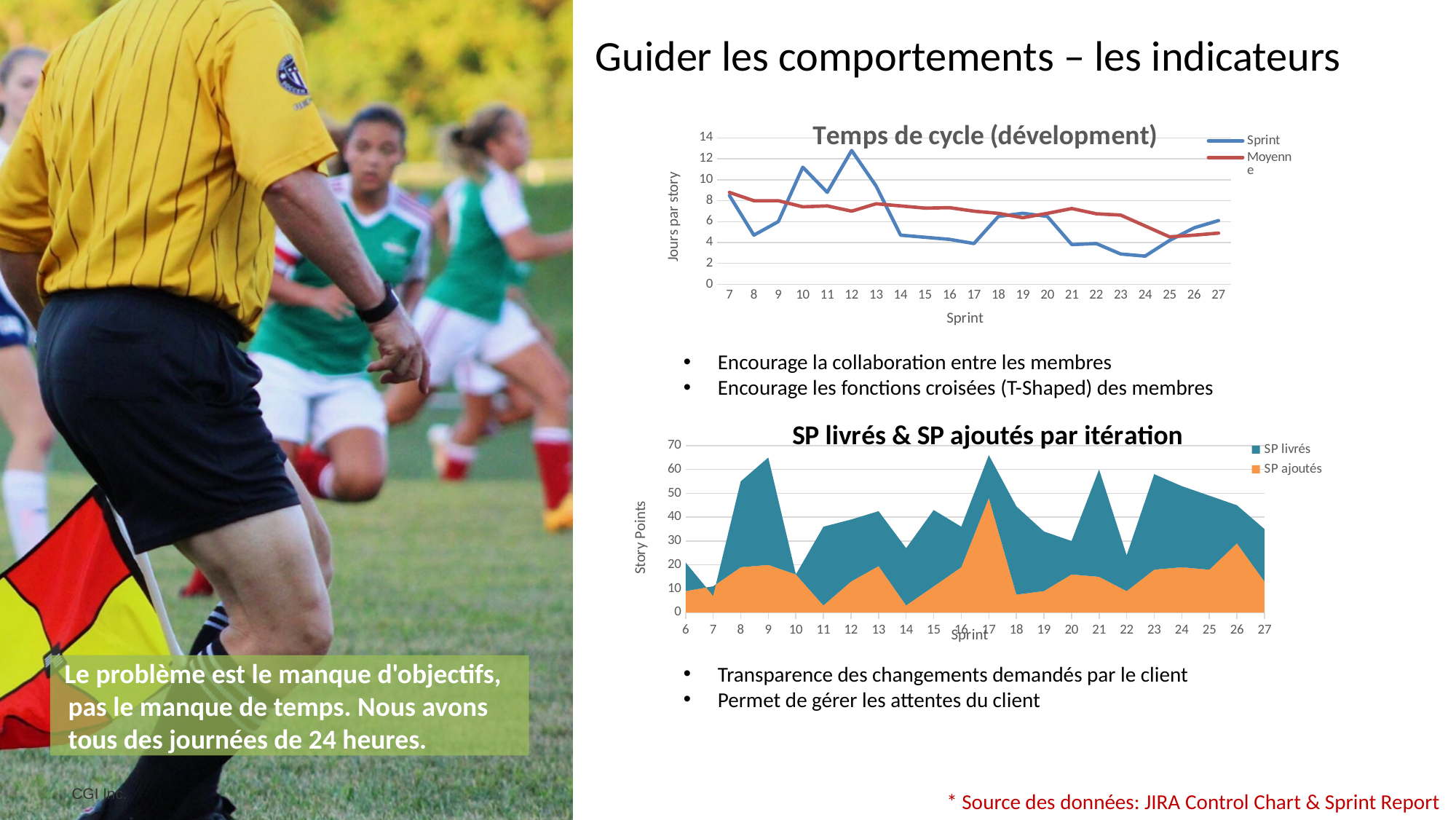
In the 'Temps de cycle (dévelopment)' chart, does the Moyenne series generally rise or fall from sprint 7 to sprint 27? fall What type of chart is 'SP livrés & SP ajoutés par itération'? area chart In the 'SP livrés & SP ajoutés par itération' chart, is the SP ajoutés value at sprint 17 greater or less than 40? greater What type of chart is the 'Temps de cycle (dévelopment)' chart? line chart In the 'SP livrés & SP ajoutés par itération' chart, at which sprint does SP ajoutés reach its highest value? 17 In the 'Temps de cycle (dévelopment)' chart, at which sprint does the Sprint series reach its highest value? 12 In the 'Temps de cycle (dévelopment)' chart, at which sprint does the Sprint series reach its lowest value? 24 How many sprints are shown on the x axis of the 'SP livrés & SP ajoutés par itération' chart? 22 How many series does the legend of the 'Temps de cycle (dévelopment)' chart list? 2 In the 'Temps de cycle (dévelopment)' chart, is the Sprint value at sprint 24 greater or less than 4? less In the 'Temps de cycle (dévelopment)' chart, is the Sprint value at sprint 12 greater or less than 10? greater What is the y-axis label of the 'Temps de cycle (dévelopment)' chart? Jours par story